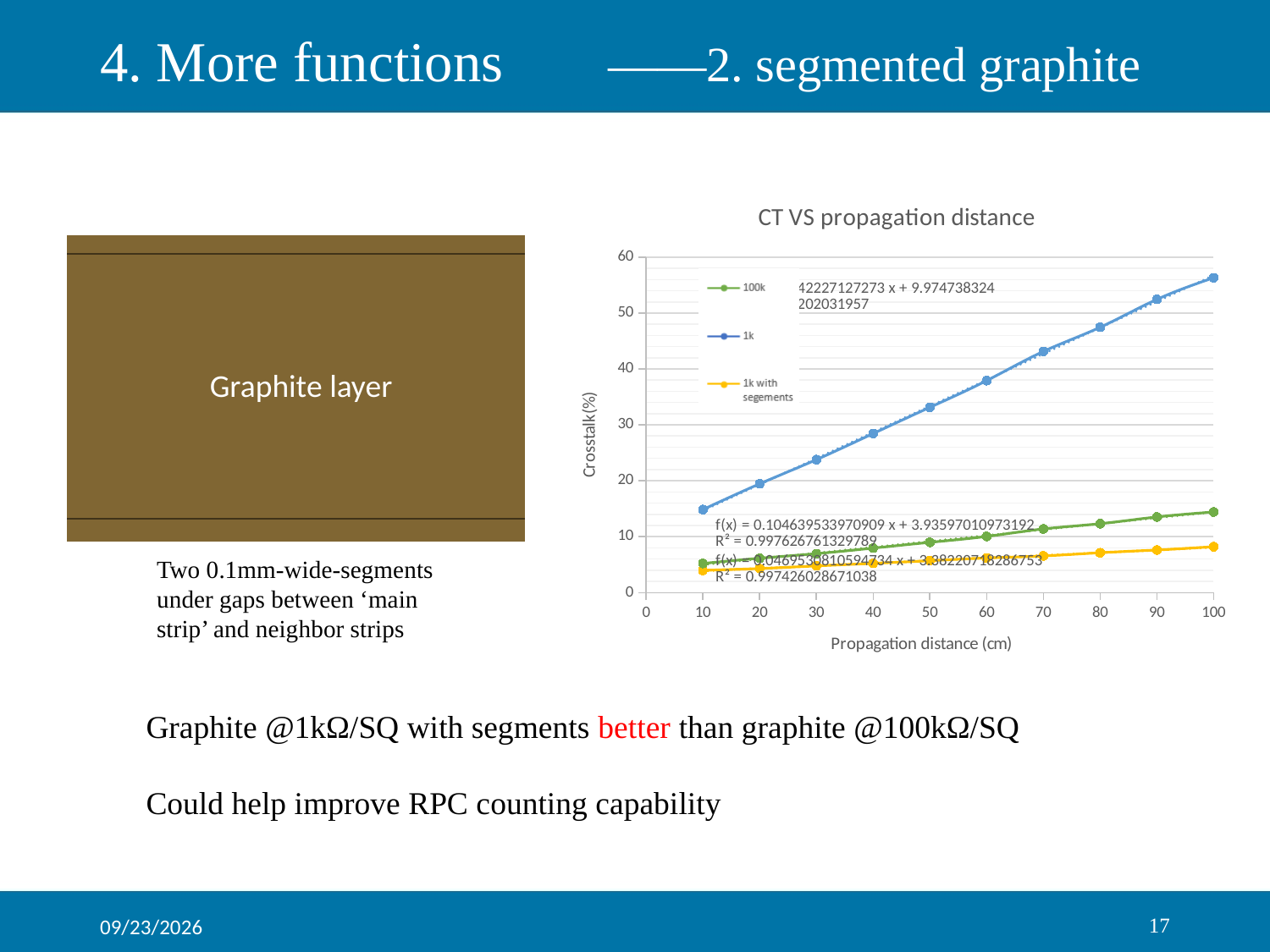
At a propagation distance of 100 cm, which series has the larger crosstalk, 100k or 1k with segements? 100k Does the crosstalk for the 1k series rise or fall as propagation distance increases? rise Is the crosstalk for the 1k series at 100 cm greater or less than 50? greater Which series has the highest crosstalk at a propagation distance of 100 cm? 1k What is the label of the y axis of the chart? Crosstalk(%) What type of chart is shown on the slide? line chart How many data points are plotted for the 1k series? 10 Which series has the lowest crosstalk at a propagation distance of 100 cm? 1k with segements How many series does the chart legend list? 3 Is the crosstalk for the 1k series at 50 cm greater or less than 30? greater Is the crosstalk for the 1k with segements series at 100 cm greater or less than 10? less What is the title of the chart? CT VS propagation distance